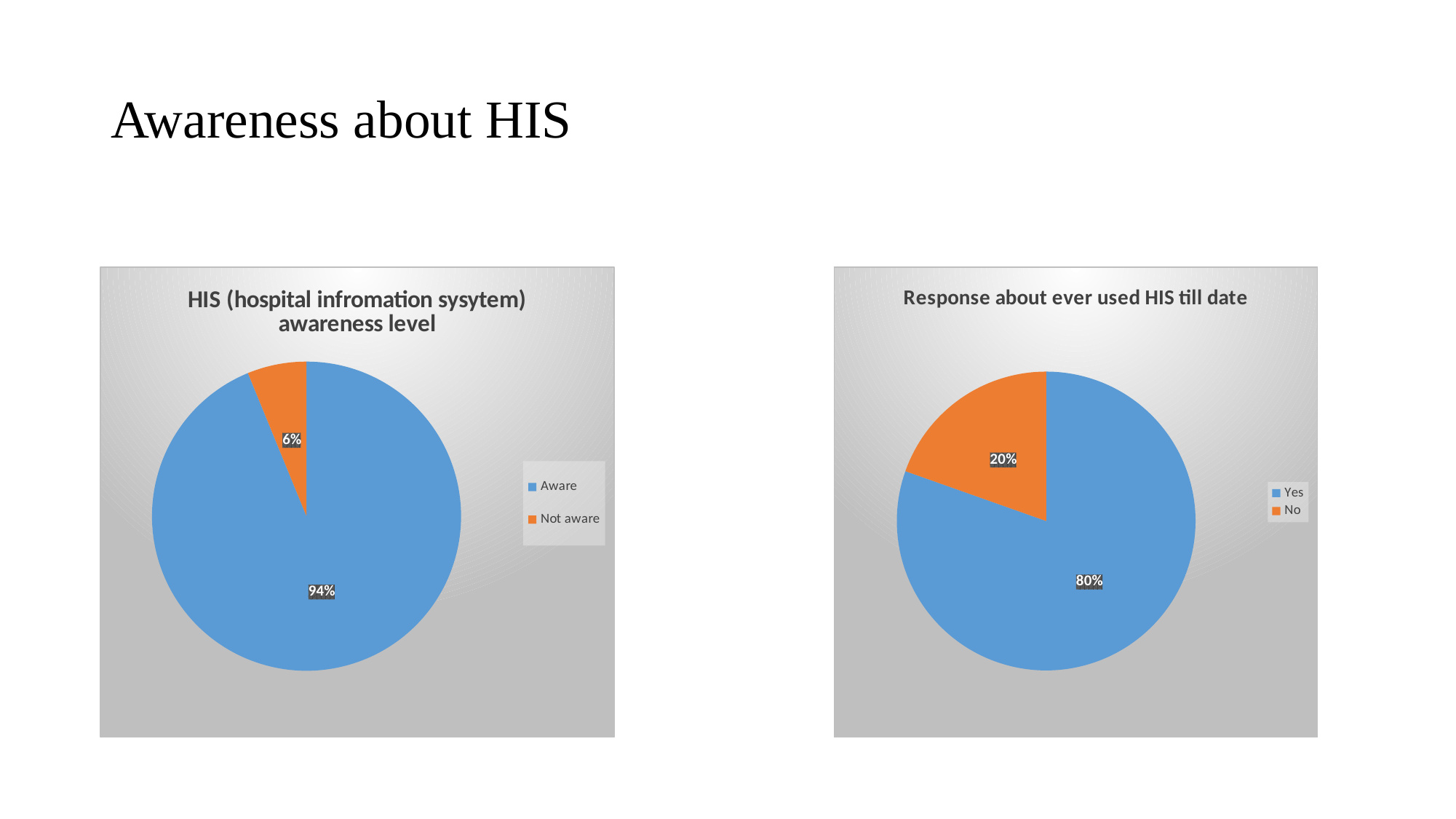
In the right chart (Response about ever used HIS till date), which is larger, Yes or No? Yes How many categories does the legend of the right chart (Response about ever used HIS till date) list? 2 In the right chart (Response about ever used HIS till date), what is the difference in percentage points between Yes and No? 60 In the left chart (HIS awareness level), what is the difference in percentage points between Aware and Not aware? 88 In the left chart (HIS awareness level), which category has the largest slice? Aware In the right chart (Response about ever used HIS till date), which category has the smallest slice? No In the left chart (HIS awareness level), what share of respondents are Not aware? 6% In the right chart (Response about ever used HIS till date), what share answered Yes? 80% In the left chart (HIS awareness level), what colour is the Not aware slice? Orange What kind of chart is the left chart (HIS awareness level)? Pie chart In the left chart (HIS awareness level), what share of respondents are Aware? 94% In the right chart (Response about ever used HIS till date), what share answered No? 20%